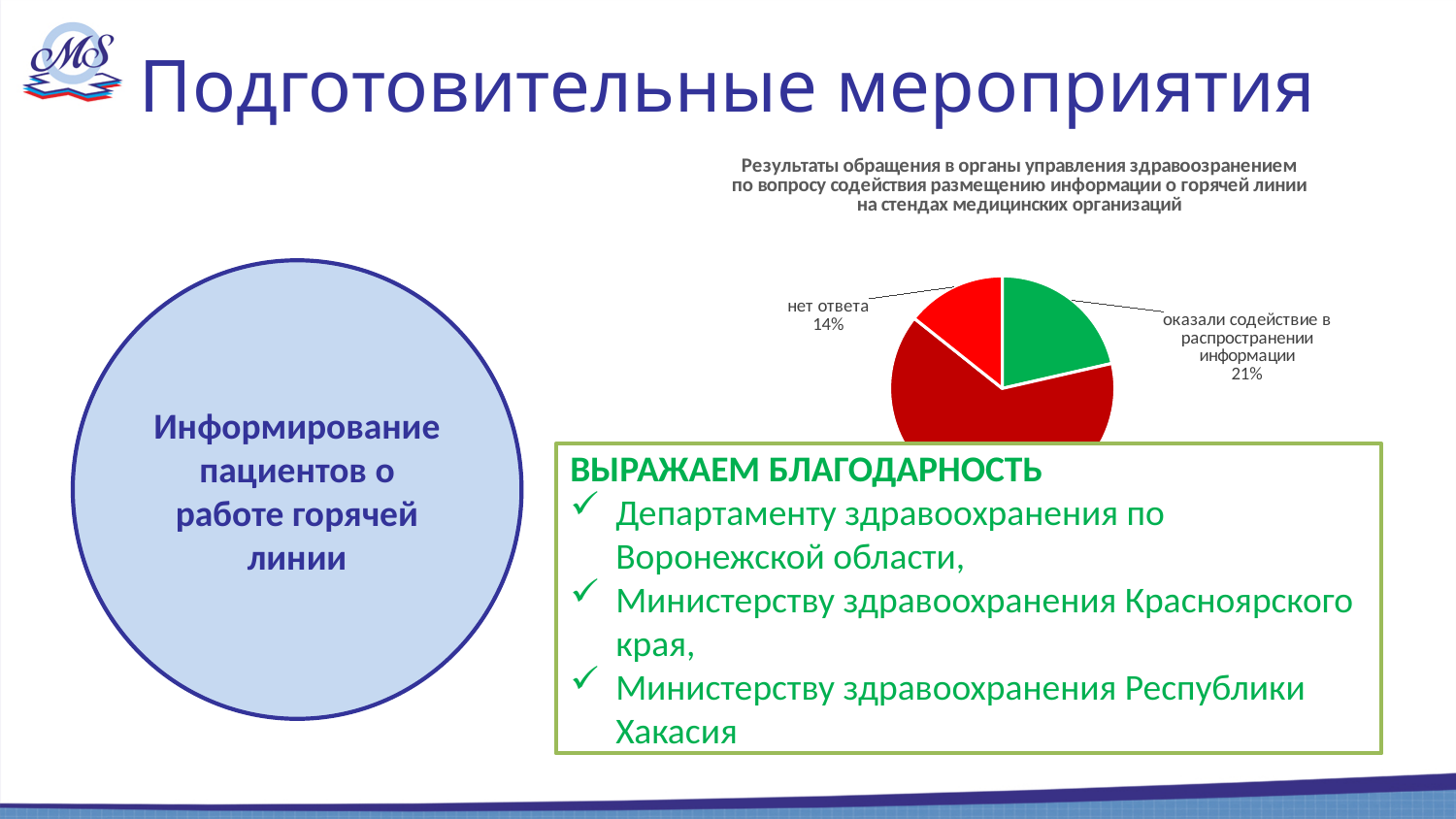
What colour is the "оказали содействие в распространении информации" slice in the pie chart? Green In the pie chart, what share is labelled for "оказали содействие в распространении информации"? 21% What is the title of the pie chart? Результаты обращения в органы управления здравоозранением по вопросу содействия размещению информации о горячей линии на стендах медицинских организаций Is the share for "нет ответа" in the pie chart greater or less than 20%? less How many slices does the pie chart have? 3 In the pie chart, what share is labelled for "нет ответа"? 14% In the pie chart, which slice is larger: "нет ответа" or "оказали содействие в распространении информации"? оказали содействие в распространении информации In the pie chart, by how many percentage points does "оказали содействие в распространении информации" exceed "нет ответа"? 7 percentage points What kind of chart is shown on the slide? Pie chart